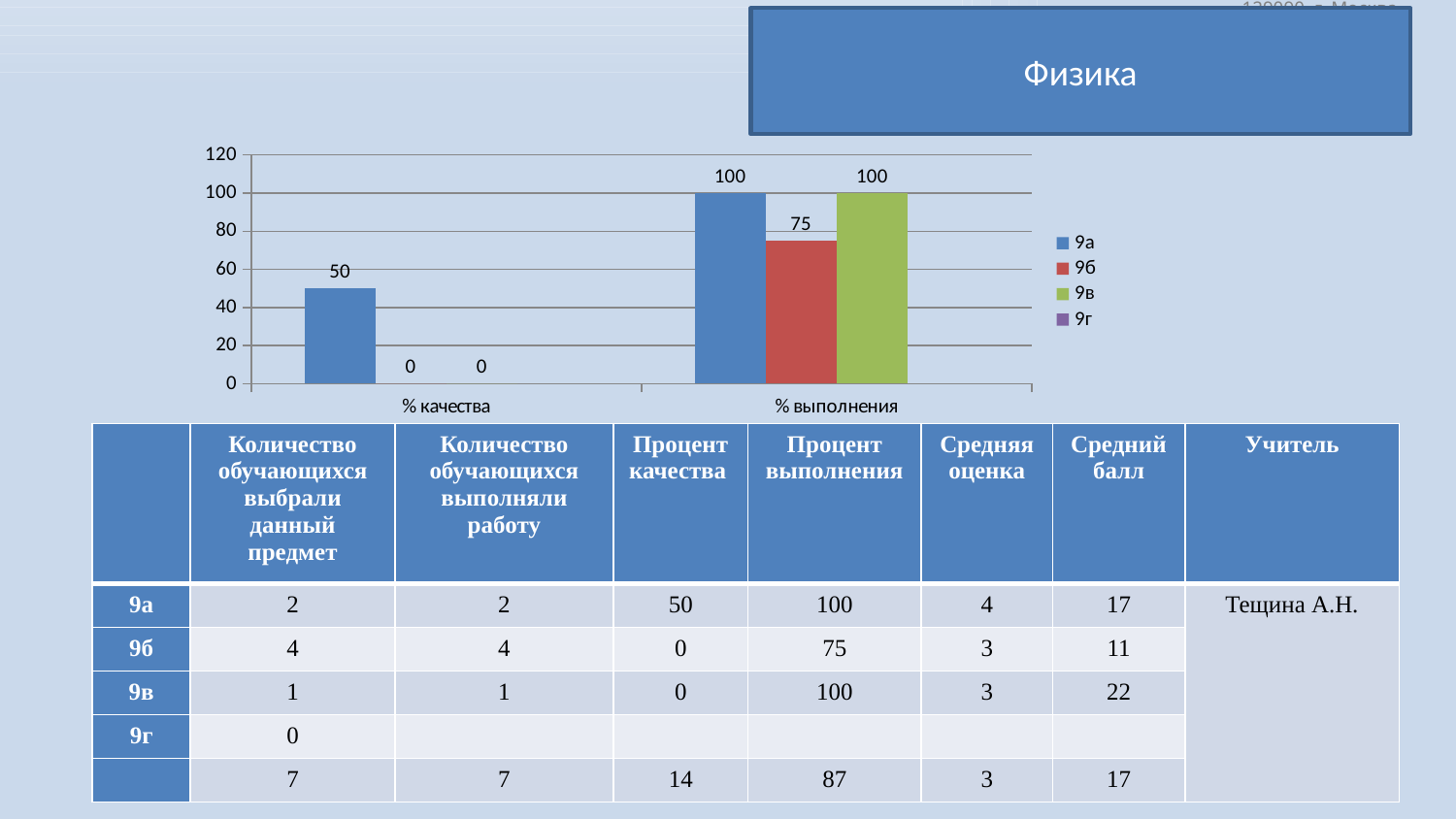
What is the maximum value shown on the chart's vertical axis? 120 What is the value for 9б in the % выполнения category? 75 How many series does the chart legend list? 4 Which series has the highest value in the % качества category? 9а What is the value for 9в in the % выполнения category? 100 What type of chart is shown on the slide? bar chart How many categories are shown on the x axis of the chart? 2 Which series has the lowest value in the % выполнения category? 9б What is the difference between the 9а and 9б values in the % выполнения category? 25 What is the value for 9а in the % качества category? 50 Which is larger: the 9а value for % качества or the 9а value for % выполнения? % выполнения What is the value for 9б in the % качества category? 0